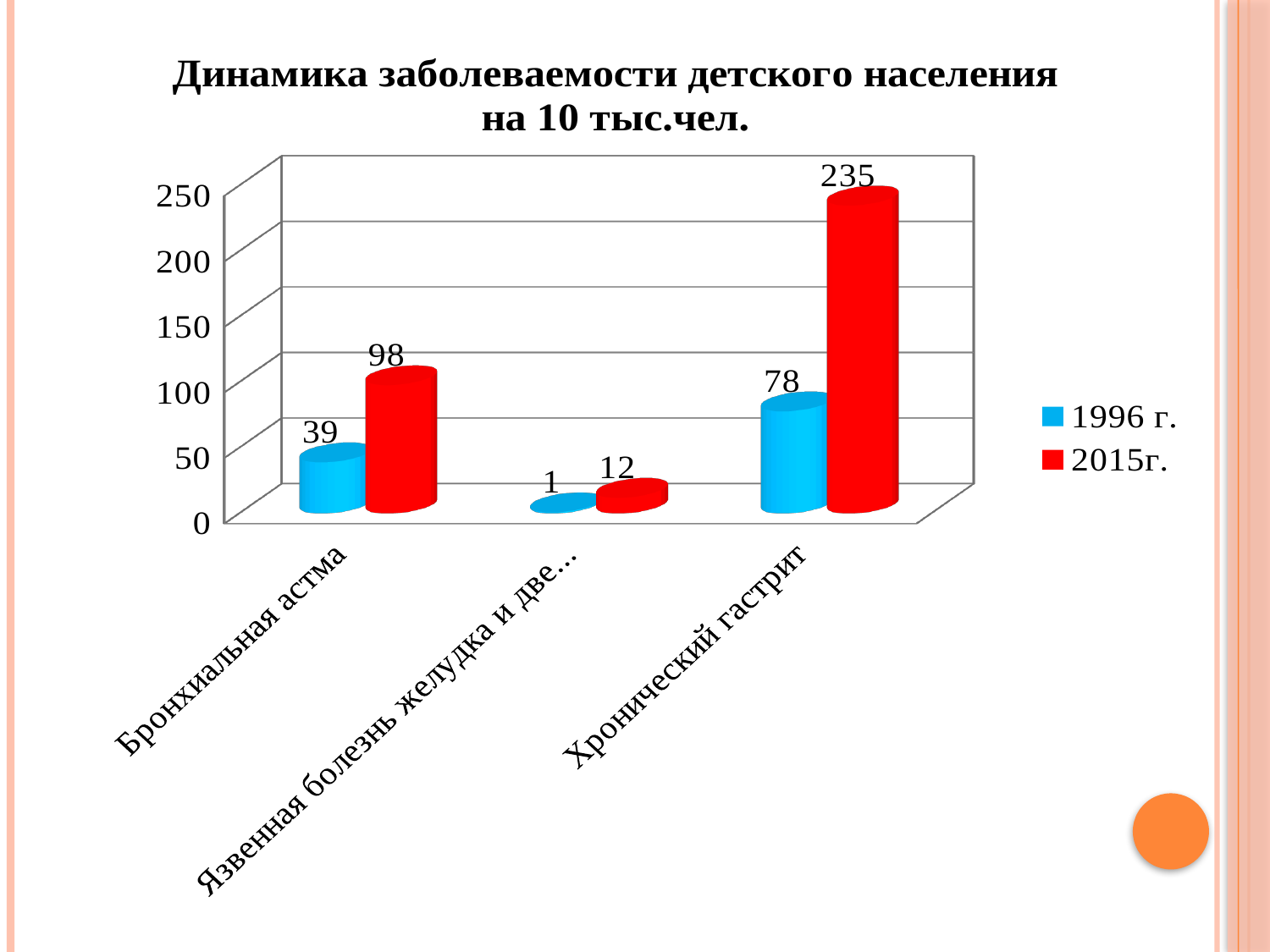
What is the value for Хронический гастрит in 1996 г.? 78 What is the value for Бронхиальная астма in 1996 г.? 39 What is the value for Бронхиальная астма in 2015г.? 98 What kind of chart is shown on the slide? Bar chart Which category has the lowest value in the 1996 г. series? Язвенная болезнь желудка и две... What is the difference between the 2015г. and 1996 г. values for Хронический гастрит? 157 How many categories are shown on the x axis? 3 What is the difference between the 2015г. and 1996 г. values for Бронхиальная астма? 59 Which is larger: the 1996 г. value for Хронический гастрит or the 2015г. value for Бронхиальная астма? 2015г. value for Бронхиальная астма What is the value for Хронический гастрит in 2015г.? 235 Which category has the highest value in the 2015г. series? Хронический гастрит How many series does the legend list? 2